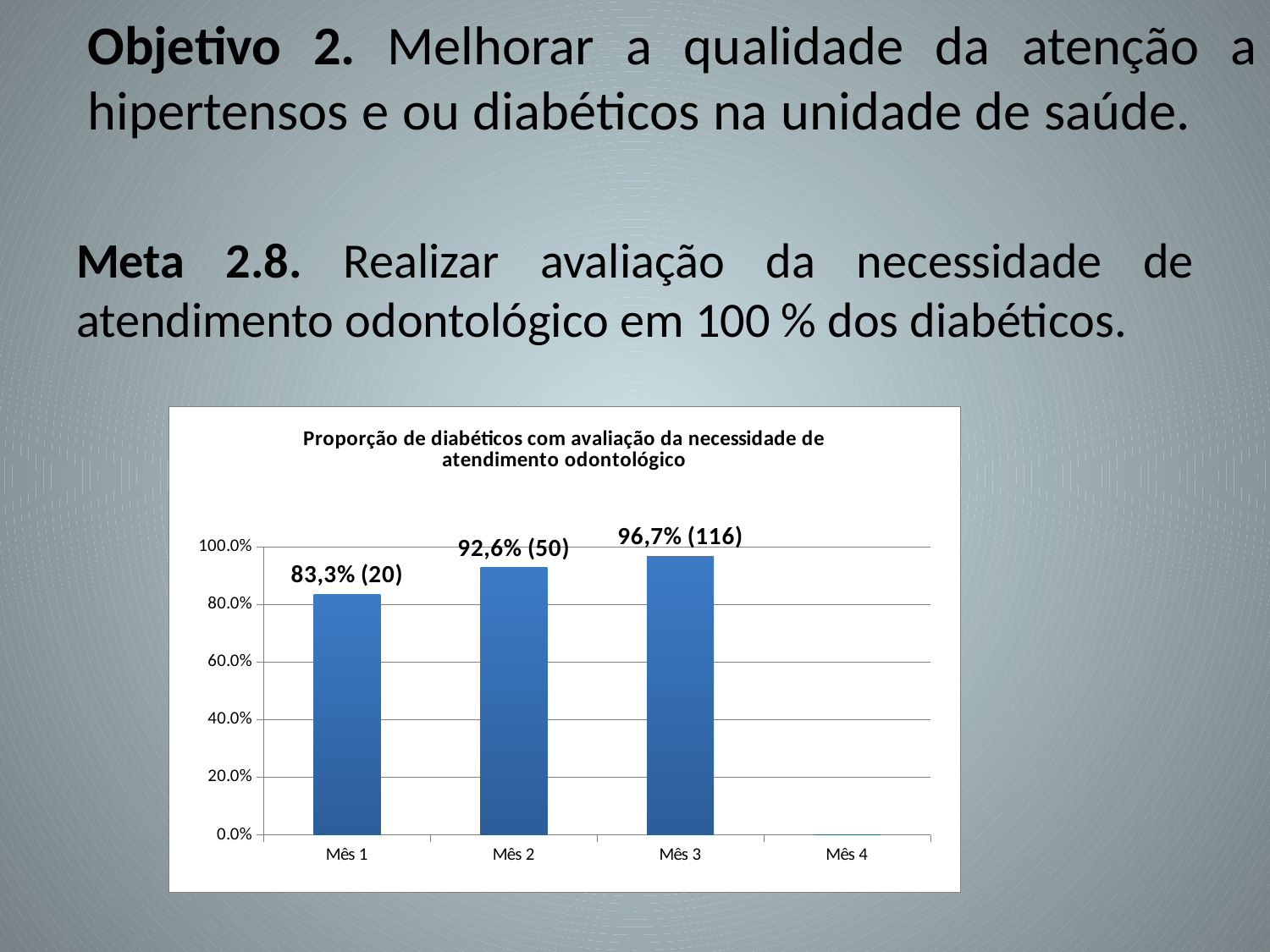
How many categories are shown on the x axis? 4 Is the value for Mês 1 greater or less than 80.0%? greater Which is larger, the value for Mês 2 or the value for Mês 1? Mês 2 Do the values rise or fall from Mês 1 to Mês 3? Rise What type of chart is shown on the slide? Bar chart What is the title of the chart? Proporção de diabéticos com avaliação da necessidade de atendimento odontológico How many diabetics are shown in parentheses for Mês 3? 116 What is the data label shown for Mês 1? 83,3% (20) What is the difference in percentage points between Mês 3 and Mês 1? 13,4 What is the data label shown for Mês 2? 92,6% (50) Which month has the highest proportion in the chart? Mês 3 What percentage is shown for Mês 3? 96,7%